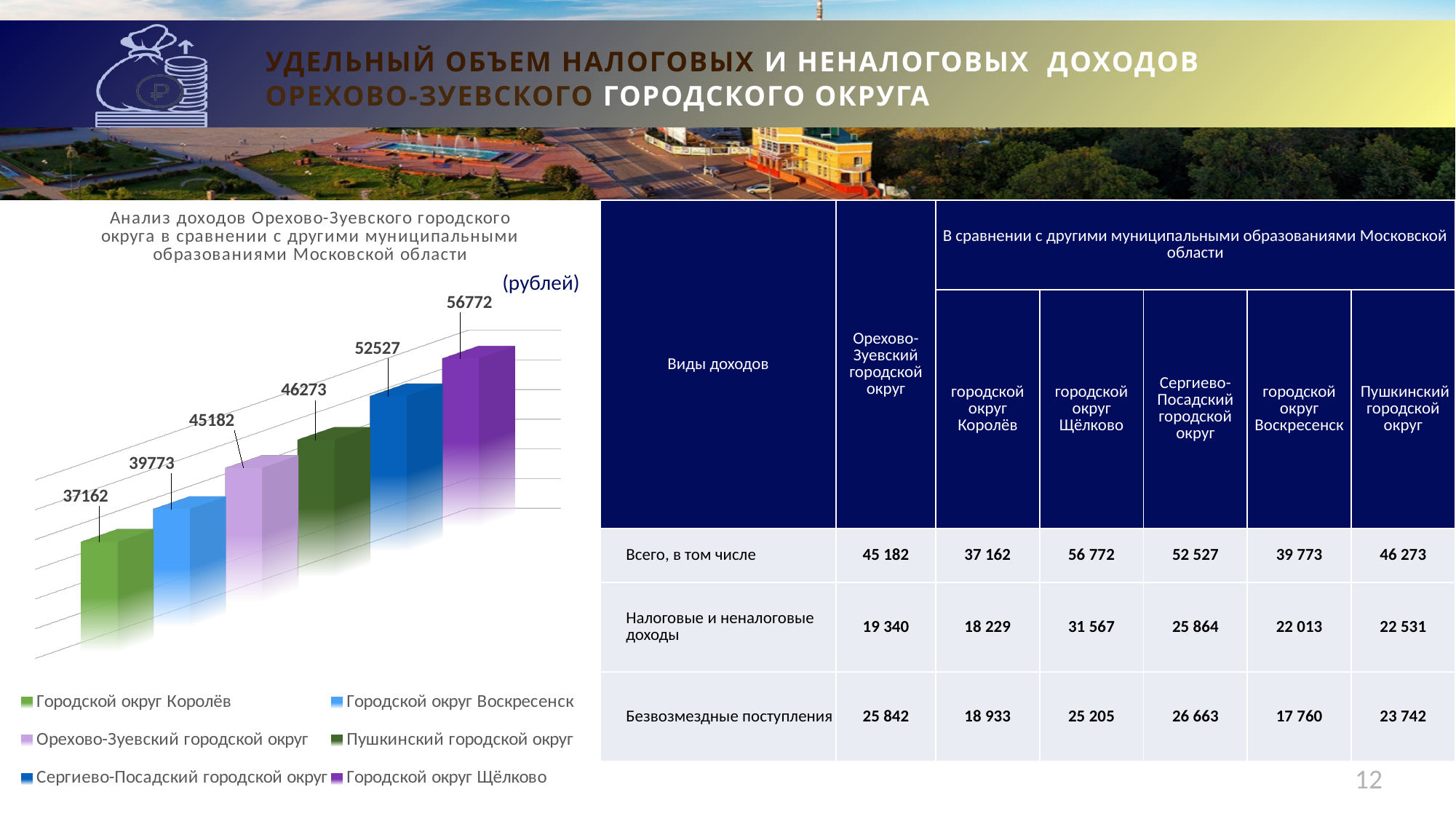
What value does the chart show for Сергиево-Посадский городской округ? 52527 Which is larger: the value for Городской округ Воскресенск or the value for Сергиево-Посадский городской округ? Сергиево-Посадский городской округ What unit is indicated for the values in the chart? рублей What is the difference between the values for Пушкинский городской округ and Орехово-Зуевский городской округ? 1091 What value does the chart show for Городской округ Королёв? 37162 What value does the chart show for Орехово-Зуевский городской округ? 45182 What value does the chart show for Городской округ Щёлково? 56772 Which municipality has the lowest value in the chart? Городской округ Королёв What kind of chart is shown on the slide? Bar chart How many series does the chart legend list? 6 What is the difference between the values for Городской округ Щёлково and Городской округ Королёв? 19610 Which municipality has the highest value in the chart? Городской округ Щёлково